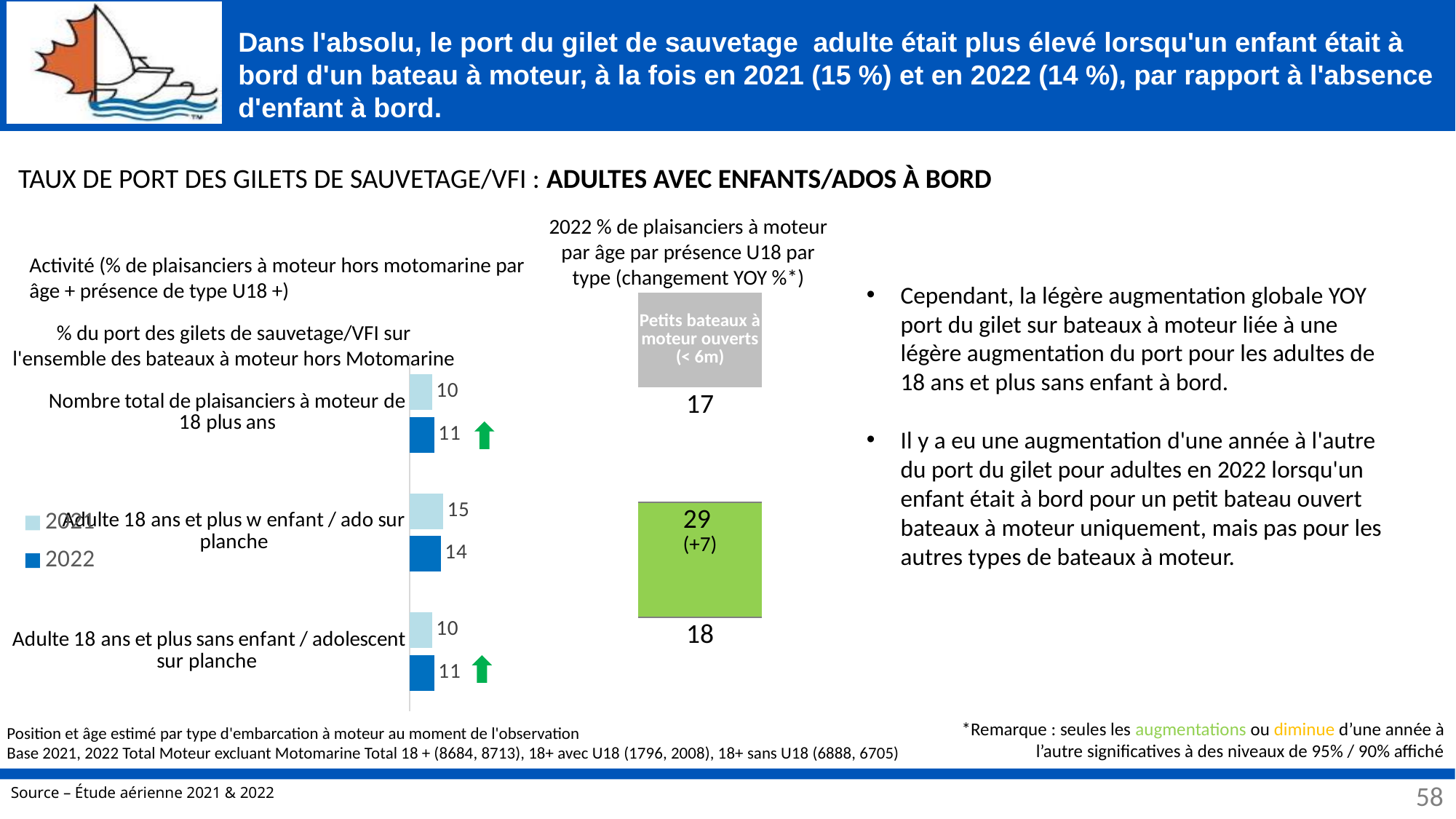
Which series is shown in light blue in the legend? 2021 What is the 2022 value for 'Nombre total de plaisanciers à moteur de 18 plus ans'? 11 How many categories are shown on the bar chart? 3 For 'Adulte 18 ans et plus sans enfant / adolescent sur planche', which year has the larger value, 2021 or 2022? 2022 What kind of chart is used to show the life jacket wearing rates by category? bar chart What is the difference between the 2021 and 2022 values for 'Adulte 18 ans et plus w enfant / ado sur planche'? 1 What is the 2022 value for 'Adulte 18 ans et plus w enfant / ado sur planche'? 14 Which category has the highest 2022 value on the bar chart? Adulte 18 ans et plus w enfant / ado sur planche What is the 2021 value for 'Adulte 18 ans et plus w enfant / ado sur planche'? 15 In the 'Petits bateaux à moteur ouverts (< 6m)' column, what is the value for adults 18 and over with a child/teen on board? 29 How many series does the chart legend list? 2 What is the 2021 value for 'Adulte 18 ans et plus sans enfant / adolescent sur planche'? 10